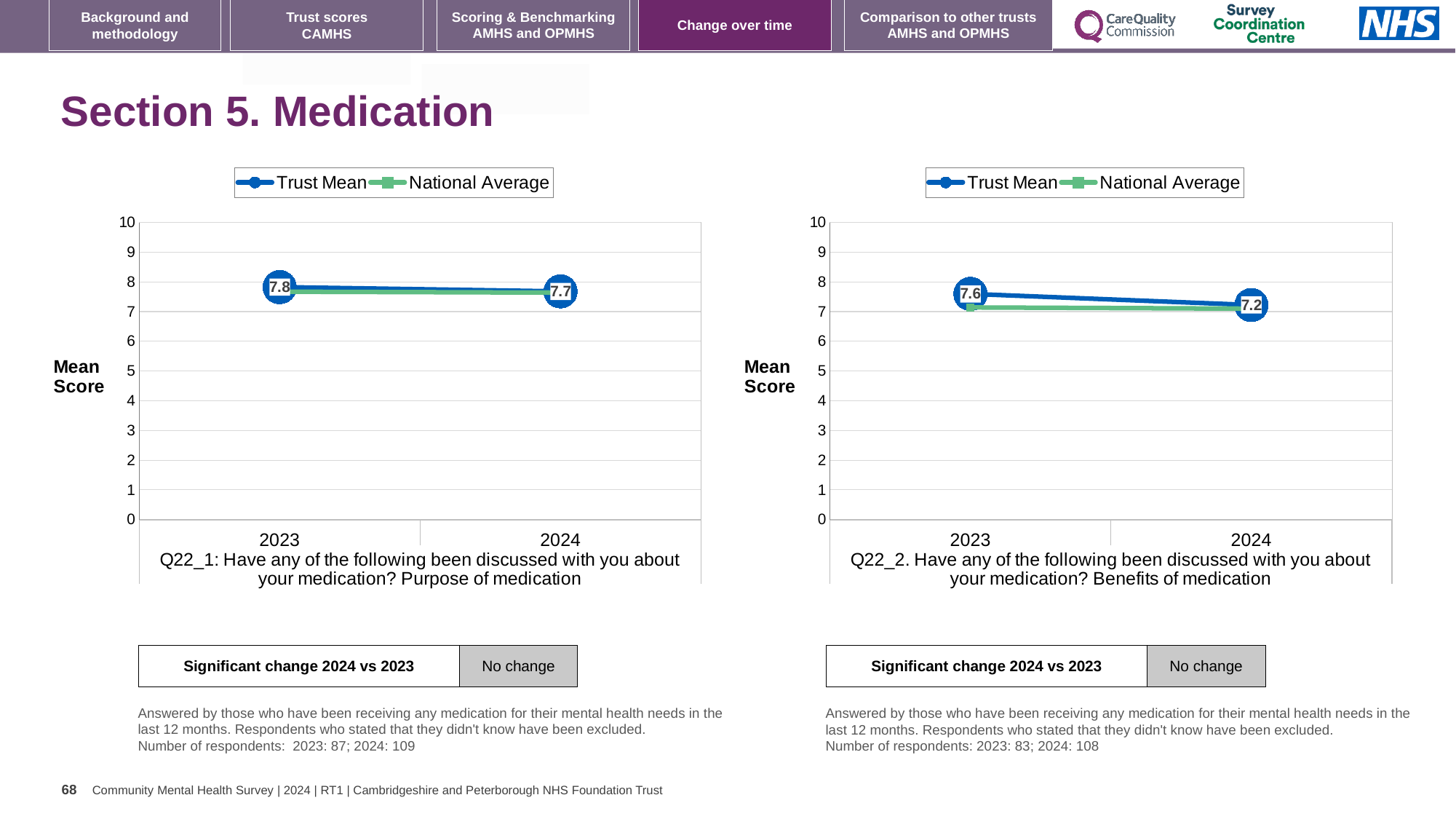
In the right chart (Q22_2: Benefits of medication), does the Trust Mean rise or fall from 2023 to 2024? fall What kind of chart is the left chart (Q22_1: Purpose of medication)? line chart In the right chart (Q22_2: Benefits of medication), is the National Average value for 2024 greater or less than 8? less In the left chart (Q22_1: Purpose of medication), what is the difference between the Trust Mean in 2023 and 2024? 0.1 How many years are shown on the x axis of the right chart (Q22_2: Benefits of medication)? 2 In the right chart (Q22_2: Benefits of medication), what is the Trust Mean score for 2024? 7.2 In the left chart (Q22_1: Purpose of medication), what is the Trust Mean score for 2023? 7.8 In the right chart (Q22_2: Benefits of medication), by how much did the Trust Mean change from 2023 to 2024? 0.4 In the left chart (Q22_1: Purpose of medication), what is the Trust Mean score for 2024? 7.7 In the left chart (Q22_1: Purpose of medication), which year has the higher Trust Mean, 2023 or 2024? 2023 In the right chart (Q22_2: Benefits of medication), what is the Trust Mean score for 2023? 7.6 How many series does the legend of the left chart (Q22_1: Purpose of medication) list? 2